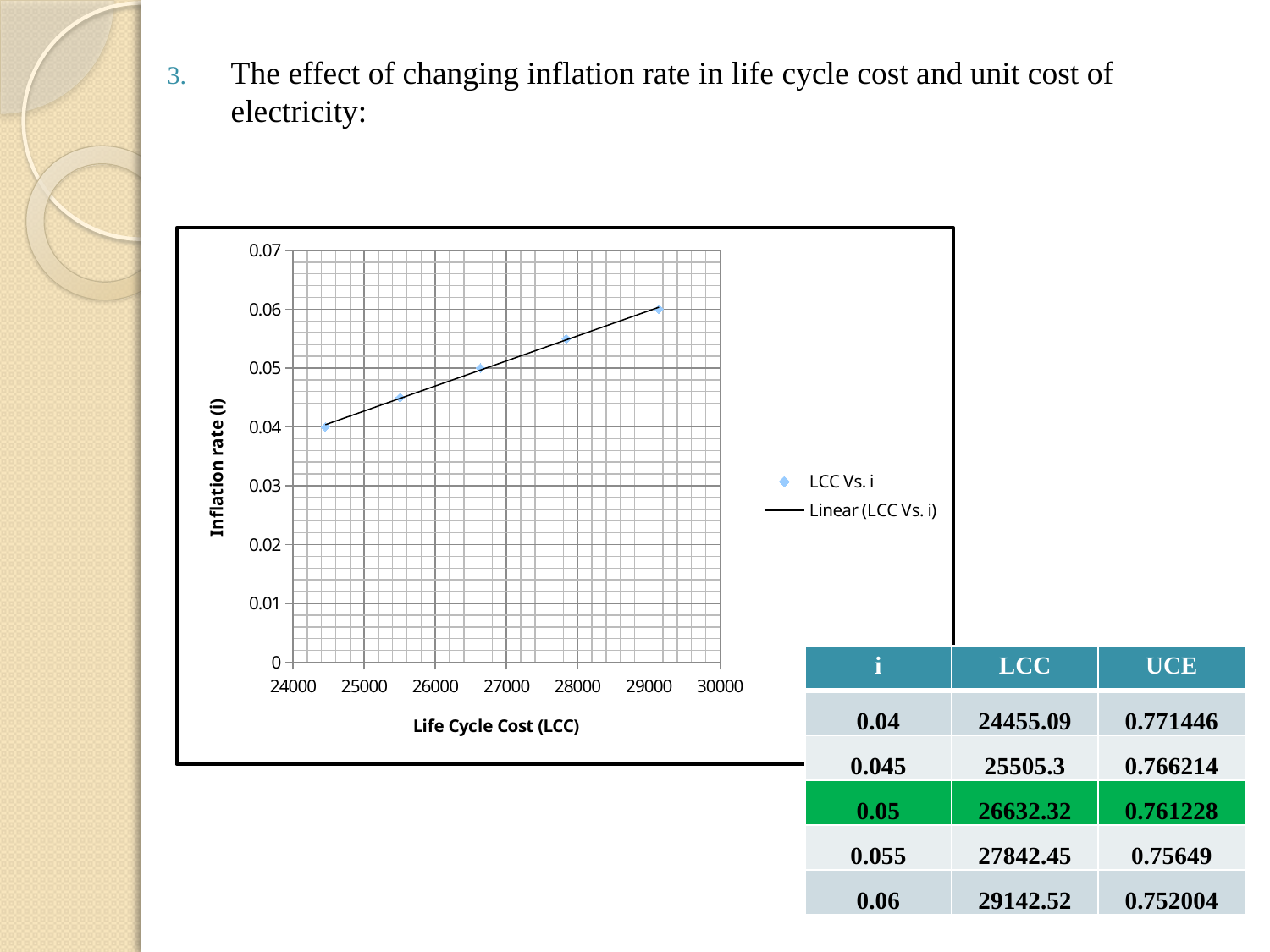
How many entries does the legend of the chart list? 2 According to the table next to the chart, what is the LCC when i is 0.05? 26632.32 What is the highest inflation rate plotted in the chart? 0.06 What are the two legend entries in the chart? LCC Vs. i and Linear (LCC Vs. i) How many data points are plotted in the LCC Vs. i chart? 5 What is the lowest inflation rate plotted in the chart? 0.04 As Life Cycle Cost increases along the x axis, does the inflation rate rise or fall? rise What kind of chart is shown on the slide? scatter chart Which has the larger Life Cycle Cost: the point at inflation rate 0.05 or the point at inflation rate 0.06? the point at inflation rate 0.06 Is the Life Cycle Cost of the point at inflation rate 0.04 greater or less than 25000? less Is the Life Cycle Cost of the point at inflation rate 0.06 greater or less than 28000? greater What is the title of the x axis of the chart? Life Cycle Cost (LCC)